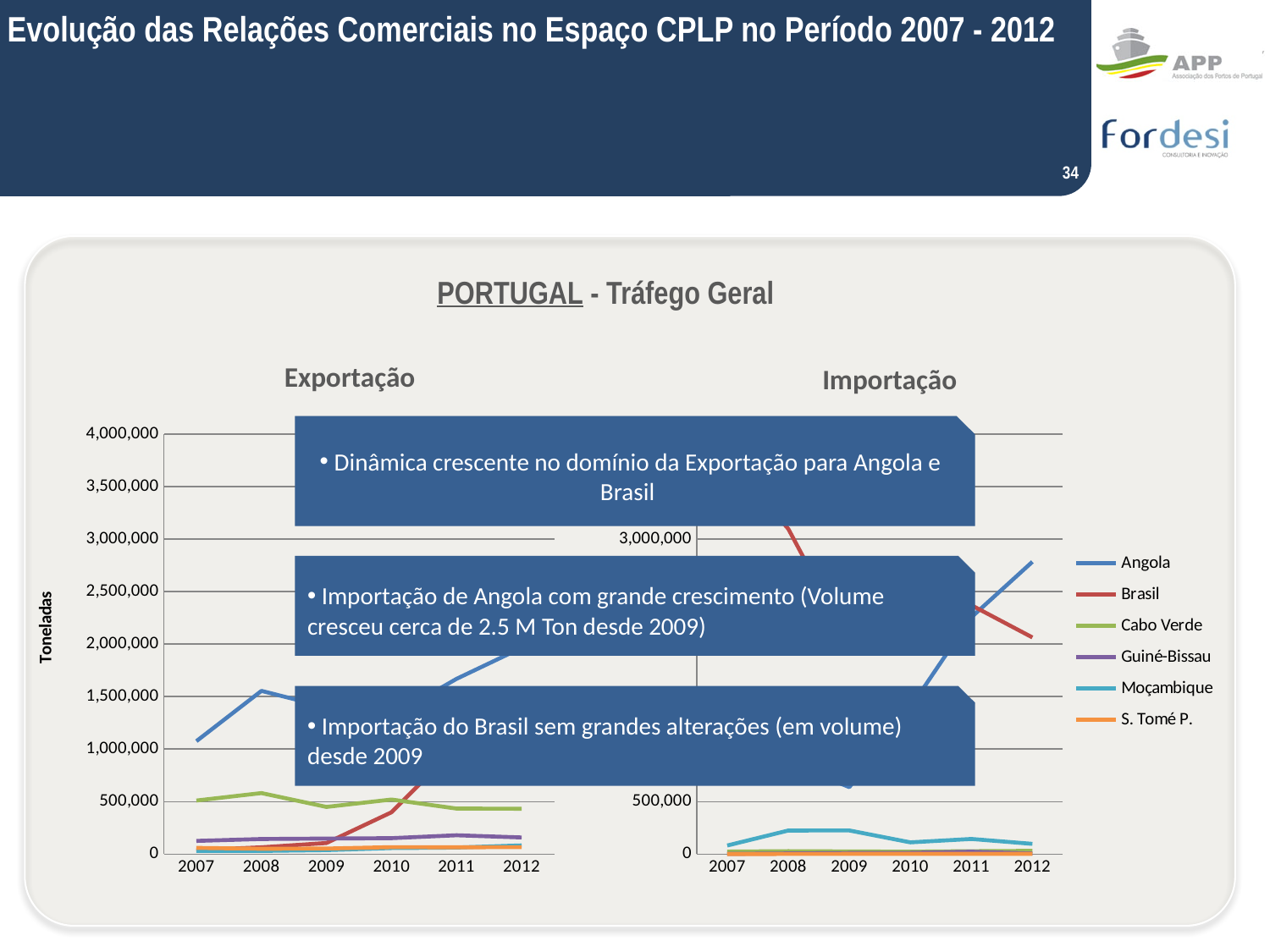
In the Exportação chart, which is larger in 2007: Angola or Cabo Verde? Angola What is the label on the vertical axis of the Exportação chart? Toneladas What kind of chart is the Exportação chart? line chart In the Importação chart, is the value for Brasil in 2012 greater or less than 2,500,000? less In the Importação chart, is the value for Angola in 2012 greater or less than 3,000,000? less How many series does the legend list for the charts? 6 In the Exportação chart, is the value for Angola in 2007 greater or less than 1,000,000? greater In the Exportação chart, does the Brasil line rise or fall from 2007 to 2010? rise How many years are shown on the x axis of the Importação chart? 6 In the Importação chart, which is larger in 2012: Angola or Brasil? Angola